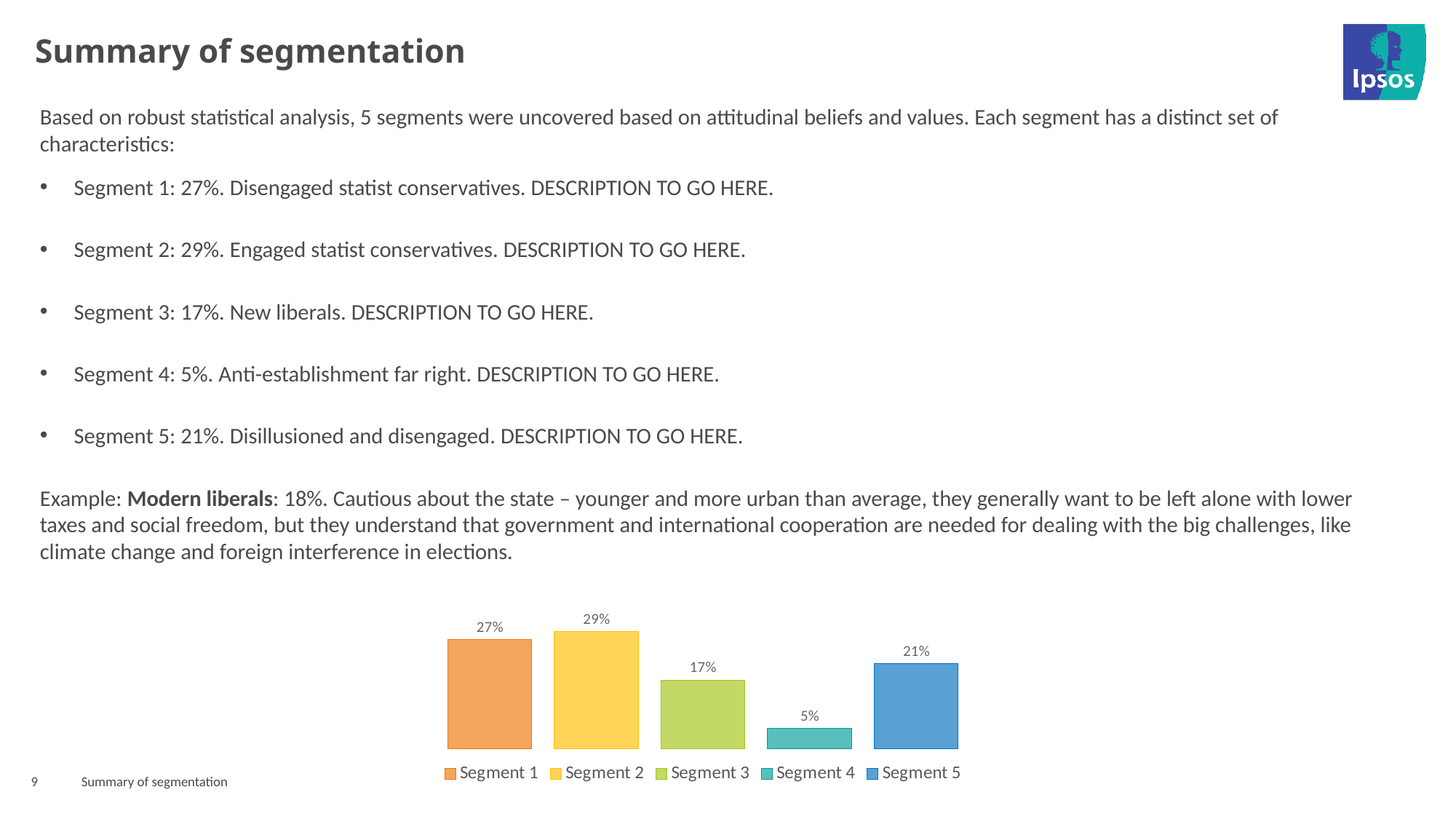
What is the value shown for Segment 1 in the chart? 27% What is the difference between the values for Segment 2 and Segment 3? 12% What is the difference between the values for Segment 1 and Segment 5? 6% What kind of chart is shown on the slide? Bar chart What is the value shown for Segment 4 in the chart? 5% How many entries does the chart legend list? 5 Which is larger, the value for Segment 3 or the value for Segment 5? Segment 5 Which segment has the lowest value in the chart? Segment 4 What is the value shown for Segment 5 in the chart? 21% Which segment has the highest value in the chart? Segment 2 How many segments are plotted in the chart? 5 What colour is the bar for Segment 2 in the chart? Yellow